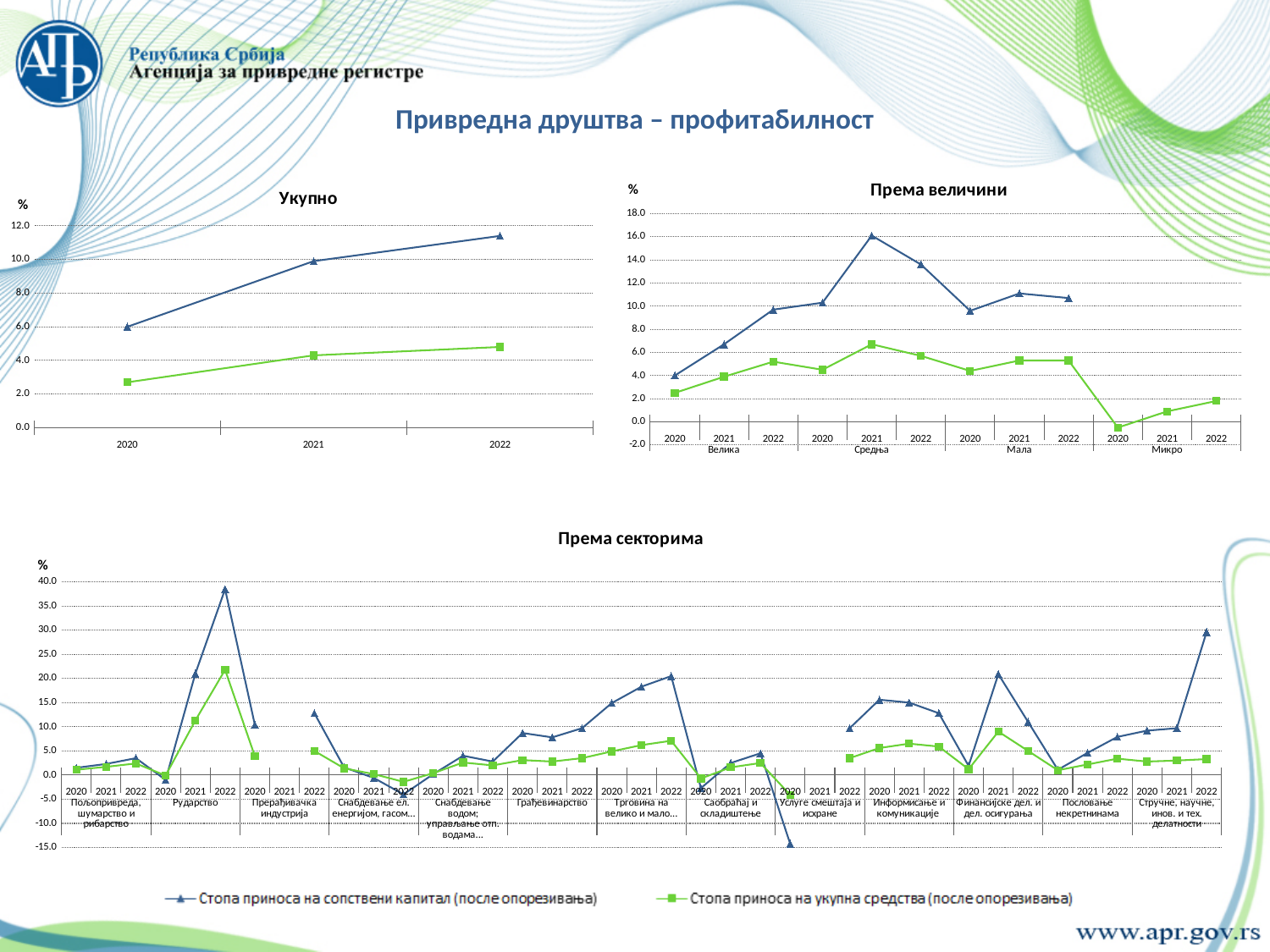
In the "Према величини" chart, how many size groups are shown on the x axis? 4 In the "Према секторима" chart, which sector has the highest value for "Стопа приноса на сопствени капитал (после опорезивања)"? Рударство In the "Укупно" chart, does the "Стопа приноса на сопствени капитал (после опорезивања)" series rise or fall from 2020 to 2022? rise What kind of chart is the "Укупно" chart? line chart How many series does the legend at the bottom of the slide list? 2 In the "Према секторима" chart, is the 2022 value for "Стопа приноса на сопствени капитал (после опорезивања)" in "Рударство" greater or less than 35.0? greater In the "Према величини" chart, in which size group and year does "Стопа приноса на сопствени капитал (после опорезивања)" reach its highest value? Средња, 2021 In the "Према секторима" chart, which is larger for "Рударство" in 2022: "Стопа приноса на сопствени капитал (после опорезивања)" or "Стопа приноса на укупна средства (после опорезивања)"? Стопа приноса на сопствени капитал (после опорезивања) In the "Укупно" chart, is the 2020 value for "Стопа приноса на укупна средства (после опорезивања)" greater or less than 4.0? less In the "Укупно" chart, how many years are shown on the x axis? 3 In the "Укупно" chart, is the 2022 value for "Стопа приноса на сопствени капитал (после опорезивања)" greater or less than 10.0? greater